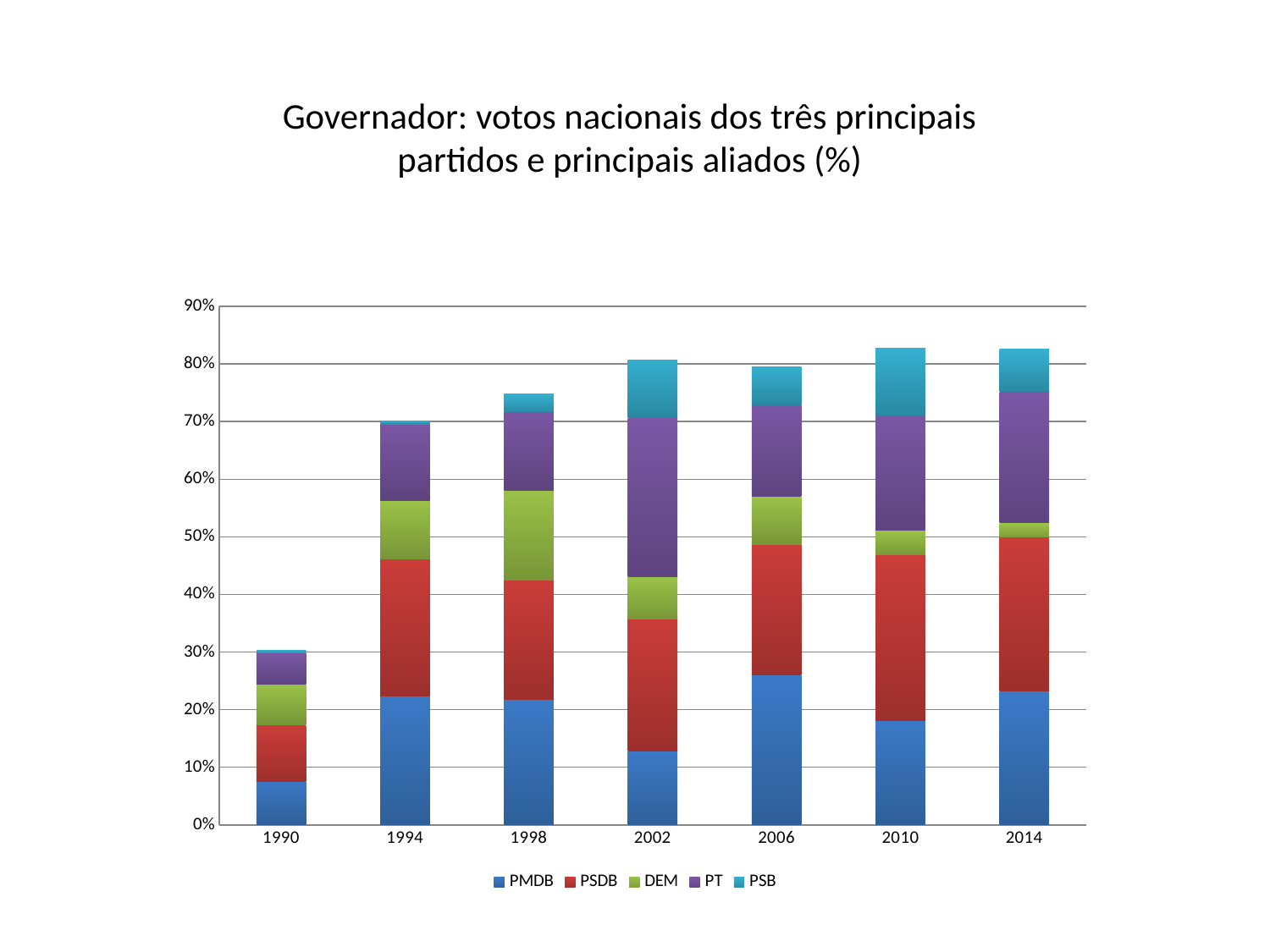
In which year is the PT segment the largest? 2002 Do the total stacked bar heights generally rise or fall from 1990 to 2014? rise In which year is the PMDB segment the largest? 2006 Which year has the lowest total stacked bar? 1990 Is the total stacked bar for 1998 greater or less than 80%? less Is the total stacked bar for 1990 greater or less than 40%? less How many series does the legend list? 5 Which year has the larger PMDB segment, 2002 or 2006? 2006 How many election years are shown on the x axis? 7 What kind of chart is shown on the slide? Stacked bar chart Which parties are listed in the legend? PMDB, PSDB, DEM, PT, PSB